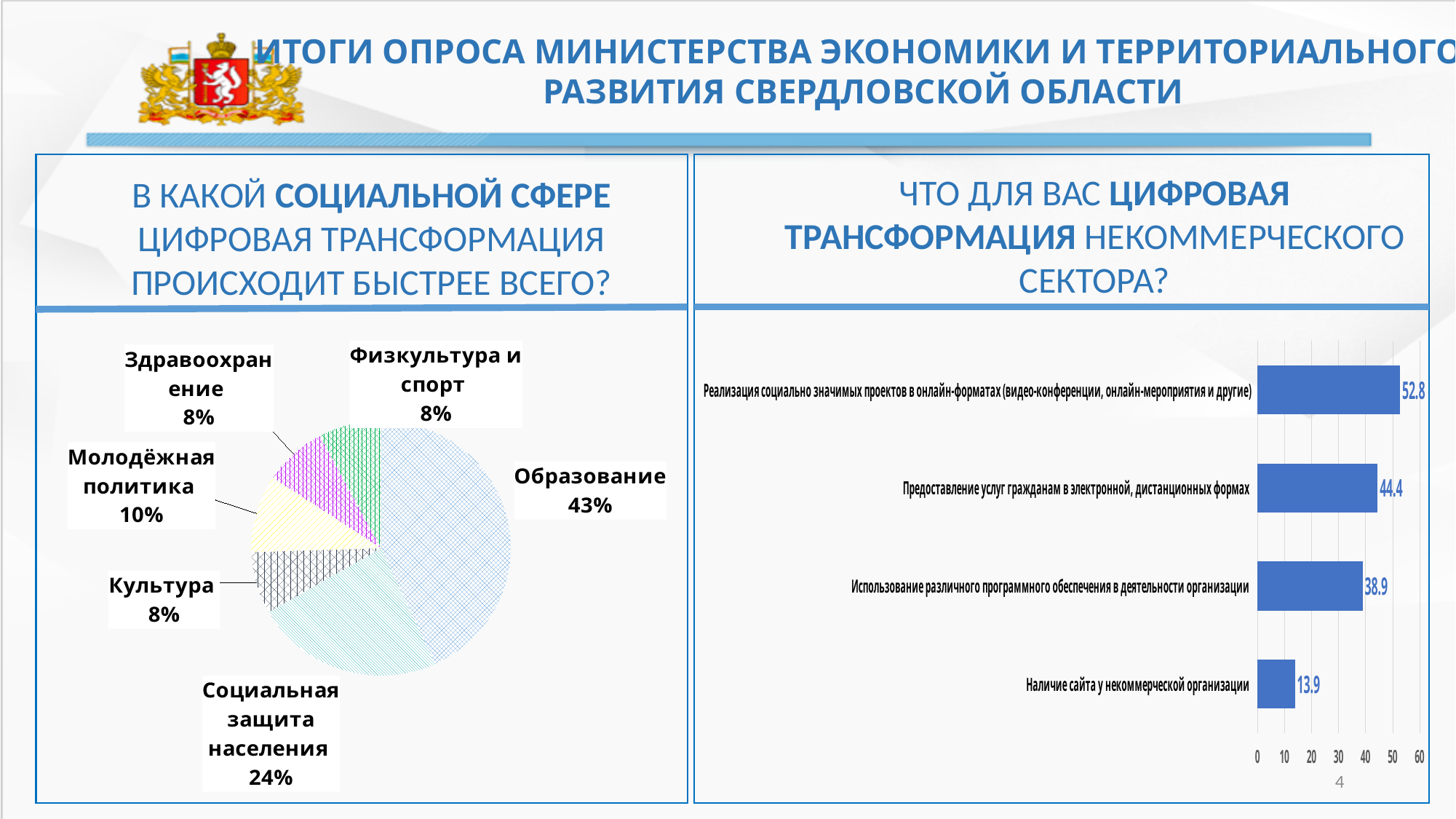
In the pie chart on the left, which is larger: Молодёжная политика or Культура? Молодёжная политика In the bar chart on the right, what is the value for Предоставление услуг гражданам в электронной, дистанционных формах? 44.4 In the pie chart on the left, what share does Социальная защита населения have? 24% In the pie chart on the left, what is the difference between the shares of Образование and Социальная защита населения? 19% In the bar chart on the right, what is the value for Наличие сайта у некоммерческой организации? 13.9 What kind of chart is on the left side of the slide? Pie chart In the pie chart on the left, which category has the largest share? Образование In the bar chart on the right, which category has the highest value? Реализация социально значимых проектов в онлайн-форматах (видео-конференции, онлайн-мероприятия и другие) What kind of chart is on the right side of the slide? Bar chart In the pie chart on the left, what share does Образование have? 43% In the bar chart on the right, what is the difference between the highest value (52.8) and the lowest value (13.9)? 38.9 In the pie chart on the left, how many categories are shown? 6